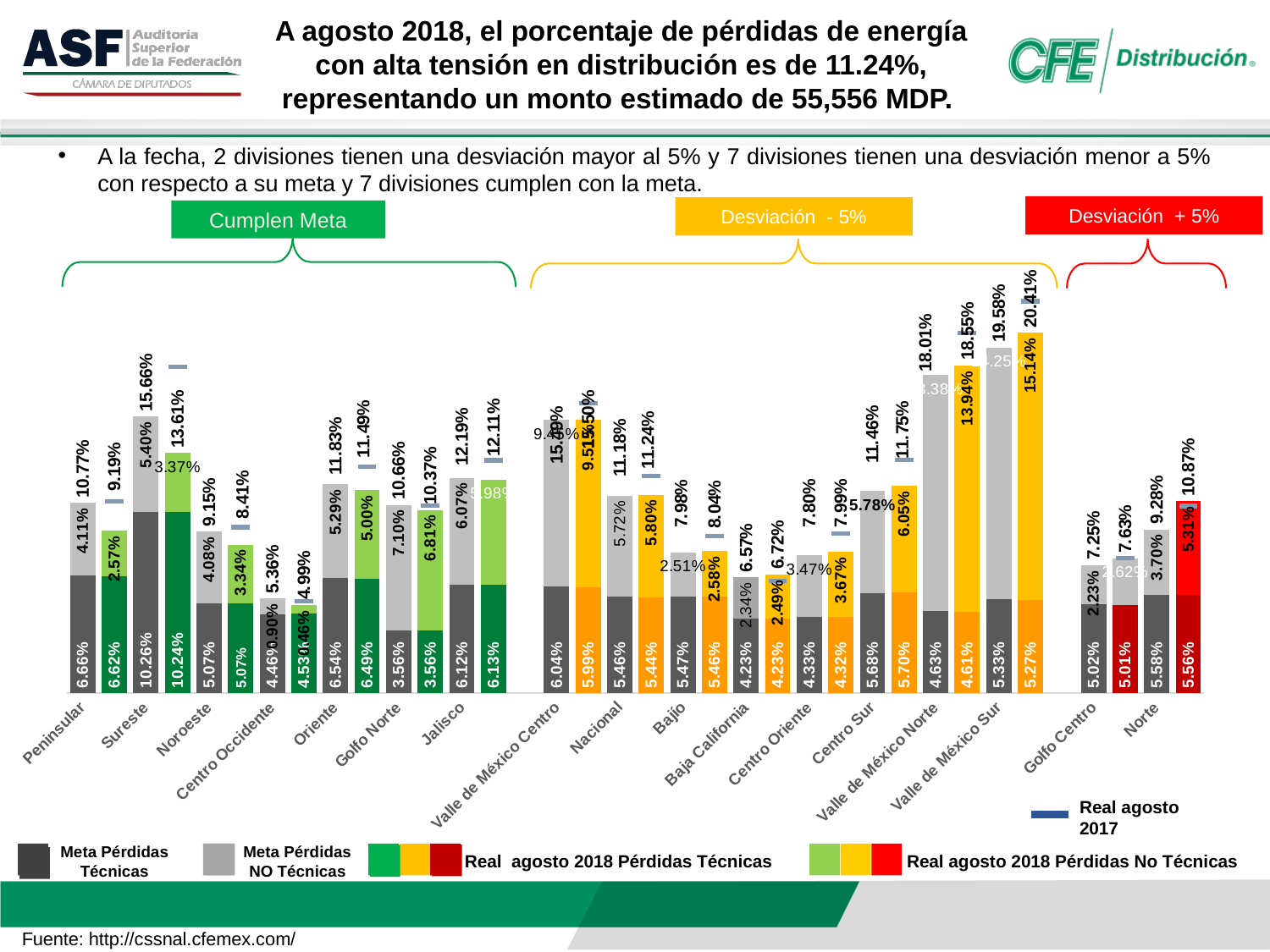
What is the Meta Pérdidas Técnicas value for Sureste? 10.26% What is the total Real agosto 2018 loss percentage for Valle de México Sur? 20.41% Which is larger for Peninsular: the Meta total or the Real agosto 2018 total? Meta total How many division categories are labelled on the x axis of the chart? 17 Which division has the highest total Real agosto 2018 loss percentage? Valle de México Sur How many entries does the chart legend list? 5 Which group label is shown in red above the chart? Desviación + 5% Which division has the lowest total Real agosto 2018 loss percentage? Centro Occidente What is the Real agosto 2018 Pérdidas No Técnicas value for Norte? 5.31% What is the difference between the Real agosto 2018 total (10.87%) and the Meta total (9.28%) for Norte? 1.59% What kind of chart is shown on the slide? Stacked bar chart What is the total Meta loss percentage for Nacional? 11.18%